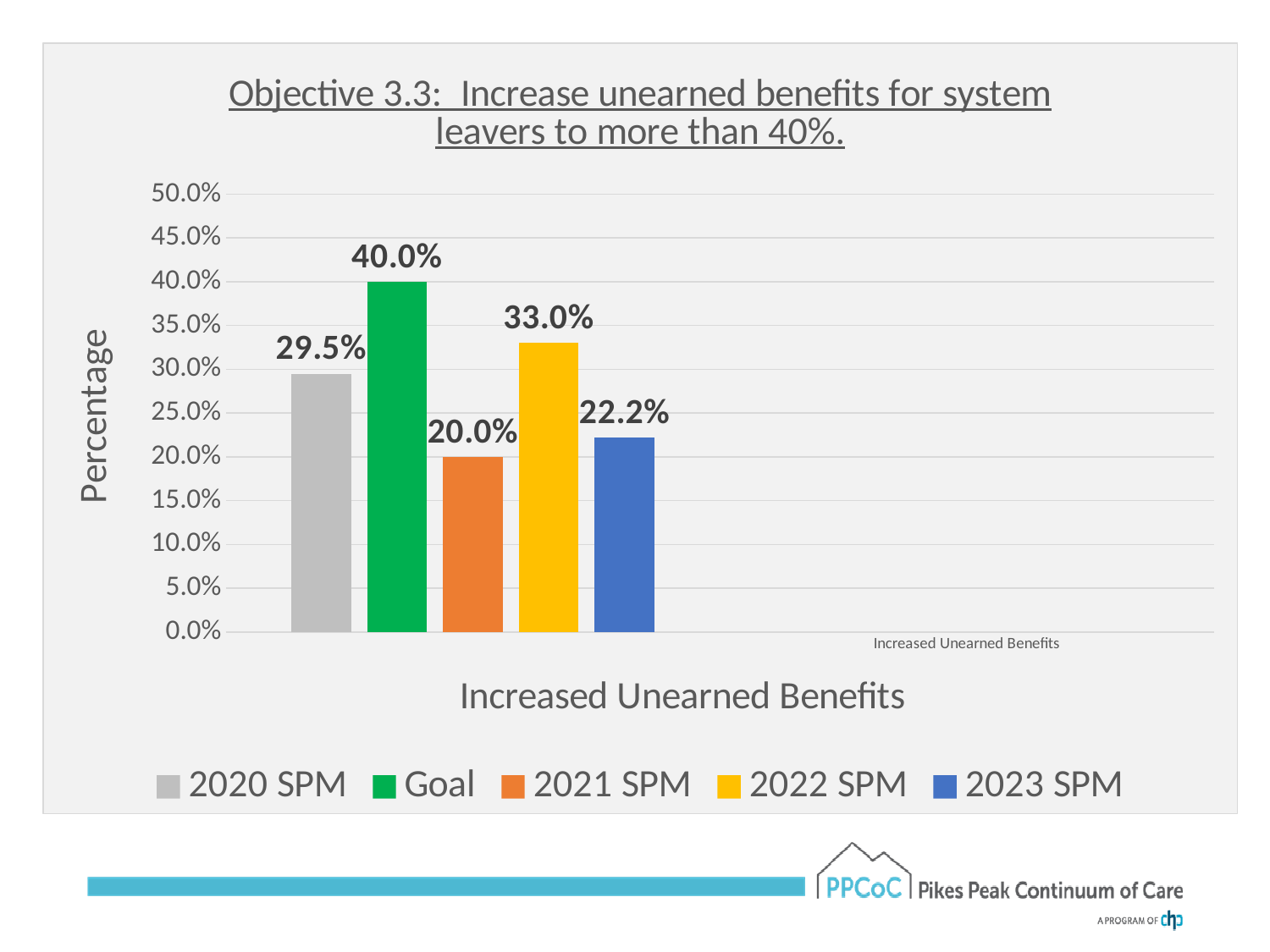
What is the value for 2021 SPM? 20.0% What is the value for 2023 SPM? 22.2% Which is larger, the value for 2020 SPM or the value for 2023 SPM? 2020 SPM Which series has the highest value? Goal What is the label on the vertical axis of the chart? Percentage How many series does the legend list? 5 What is the value for the Goal series? 40.0% What is the difference between the Goal value and the 2023 SPM value? 17.8% What kind of chart is shown on the slide? Bar chart What is the value for 2020 SPM? 29.5% What is the difference between the 2022 SPM value and the 2021 SPM value? 13.0% Which series has the lowest value? 2021 SPM